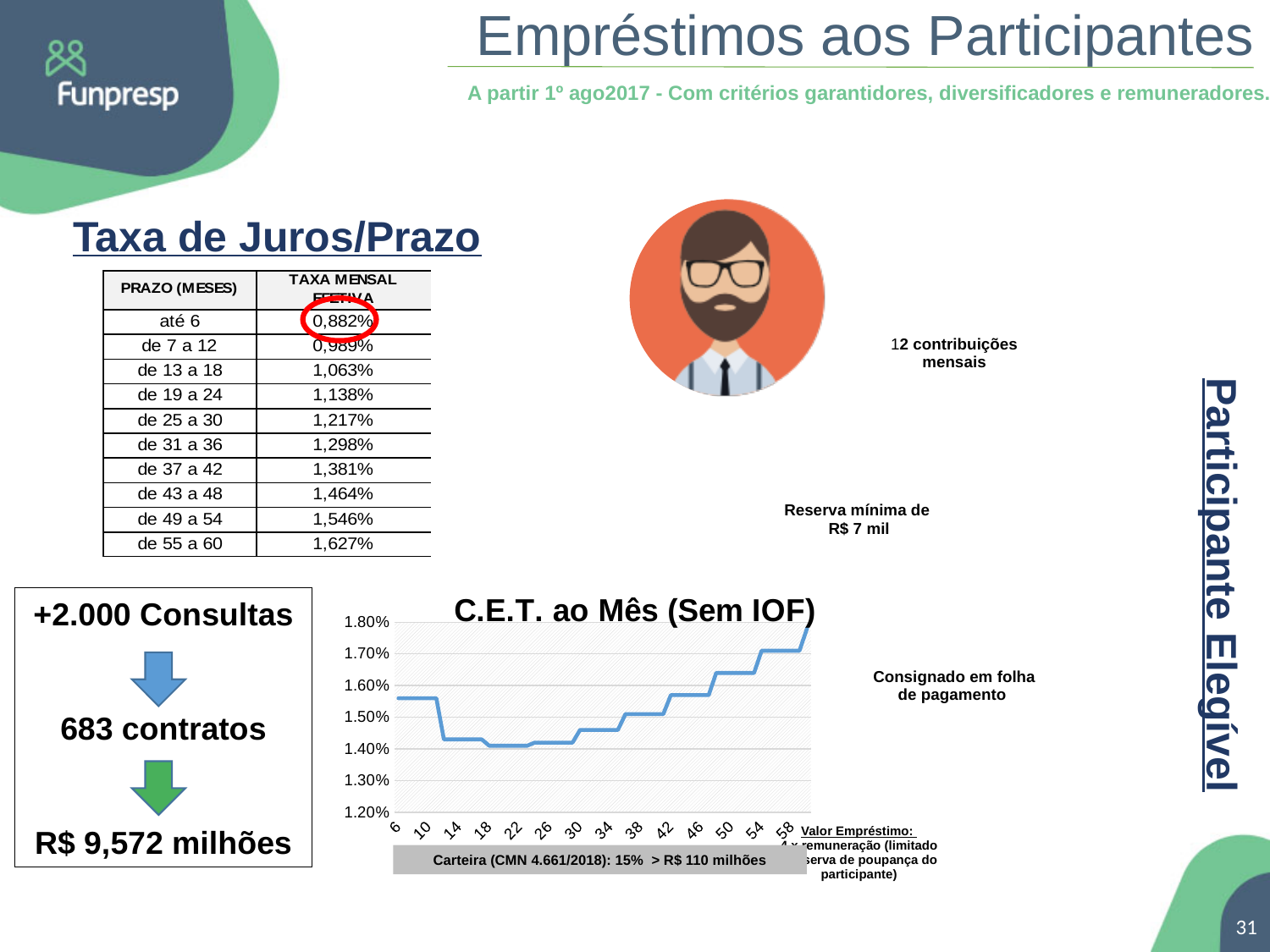
How many x-axis tick labels are shown on the "C.E.T. ao Mês (Sem IOF)" chart? 14 In the "C.E.T. ao Mês (Sem IOF)" chart, which is larger, the value at 58 or the value at 6? 58 In the "C.E.T. ao Mês (Sem IOF)" chart, which is larger, the value at 6 or the value at 22? 6 In the "C.E.T. ao Mês (Sem IOF)" chart, do the values rise or fall from 30 to 58? rise In the "C.E.T. ao Mês (Sem IOF)" chart, is the value at 22 greater or less than 1.50%? less In the "C.E.T. ao Mês (Sem IOF)" chart, is the value at 54 greater or less than 1.60%? greater In the "C.E.T. ao Mês (Sem IOF)" chart, is the value at 30 greater or less than 1.50%? less What is the title of the chart at the bottom of the slide? C.E.T. ao Mês (Sem IOF) What kind of chart is "C.E.T. ao Mês (Sem IOF)"? line chart